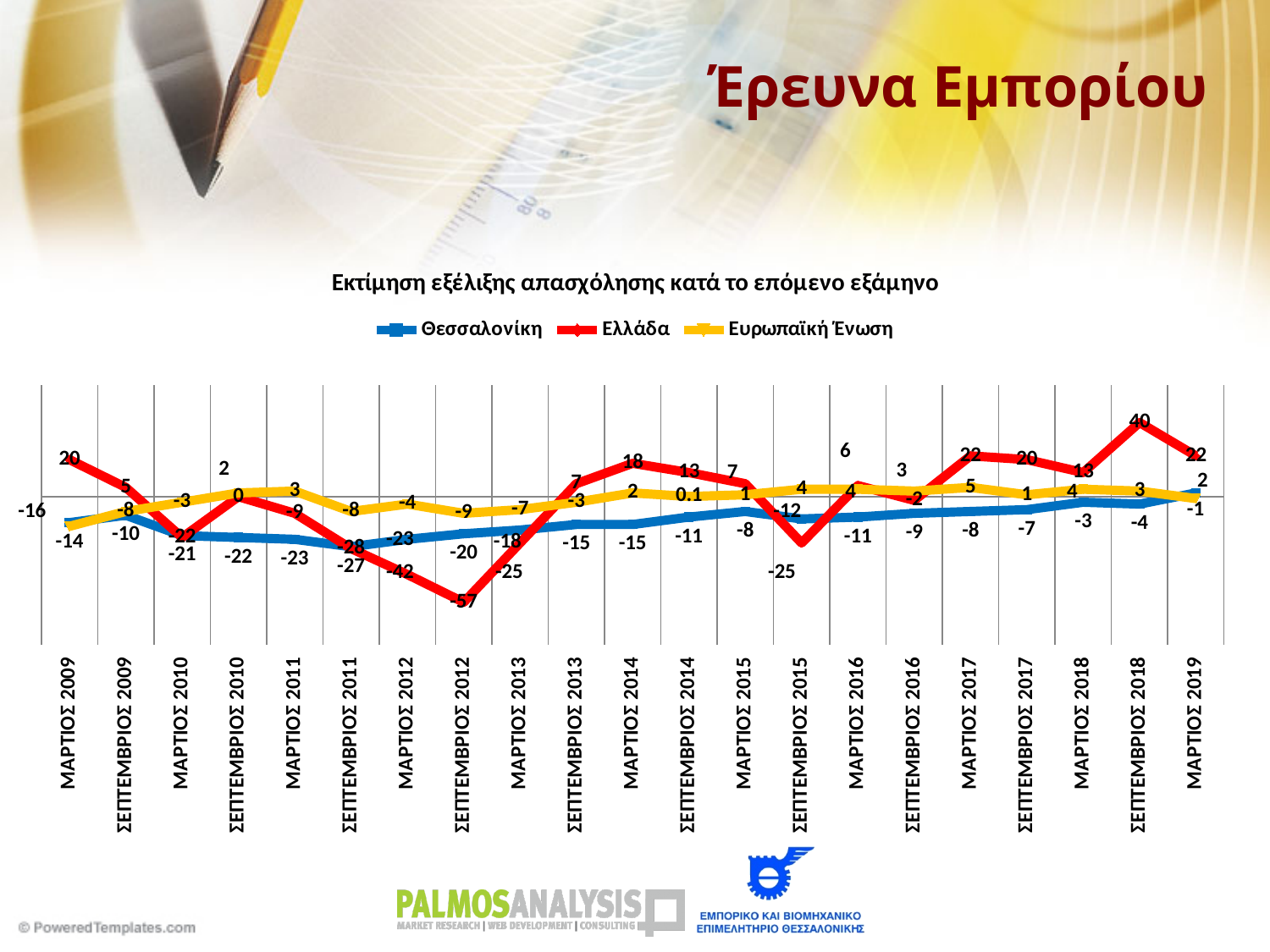
What is the title of the chart? Εκτίμηση εξέλιξης απασχόλησης κατά το επόμενο εξάμηνο Does the Θεσσαλονίκη series overall rise or fall from ΜΑΡΤΙΟΣ 2009 to ΜΑΡΤΙΟΣ 2019? Rise What is the value for Ευρωπαϊκή Ένωση in ΣΕΠΤΕΜΒΡΙΟΣ 2014? 0.1 What is the value for Ελλάδα in ΣΕΠΤΕΜΒΡΙΟΣ 2018? 40 In which period does the Ελλάδα series reach its highest value? ΣΕΠΤΕΜΒΡΙΟΣ 2018 What is the value for Θεσσαλονίκη in ΜΑΡΤΙΟΣ 2009? -14 What kind of chart is shown on the slide? Line chart How many time points are plotted along the x axis? 21 What is the difference between the Ελλάδα values in ΣΕΠΤΕΜΒΡΙΟΣ 2018 and ΜΑΡΤΙΟΣ 2019? 18 How many series does the legend list? 3 In ΣΕΠΤΕΜΒΡΙΟΣ 2012, which series has the higher value, Θεσσαλονίκη or Ελλάδα? Θεσσαλονίκη In which period does the Ελλάδα series reach its lowest value? ΣΕΠΤΕΜΒΡΙΟΣ 2012